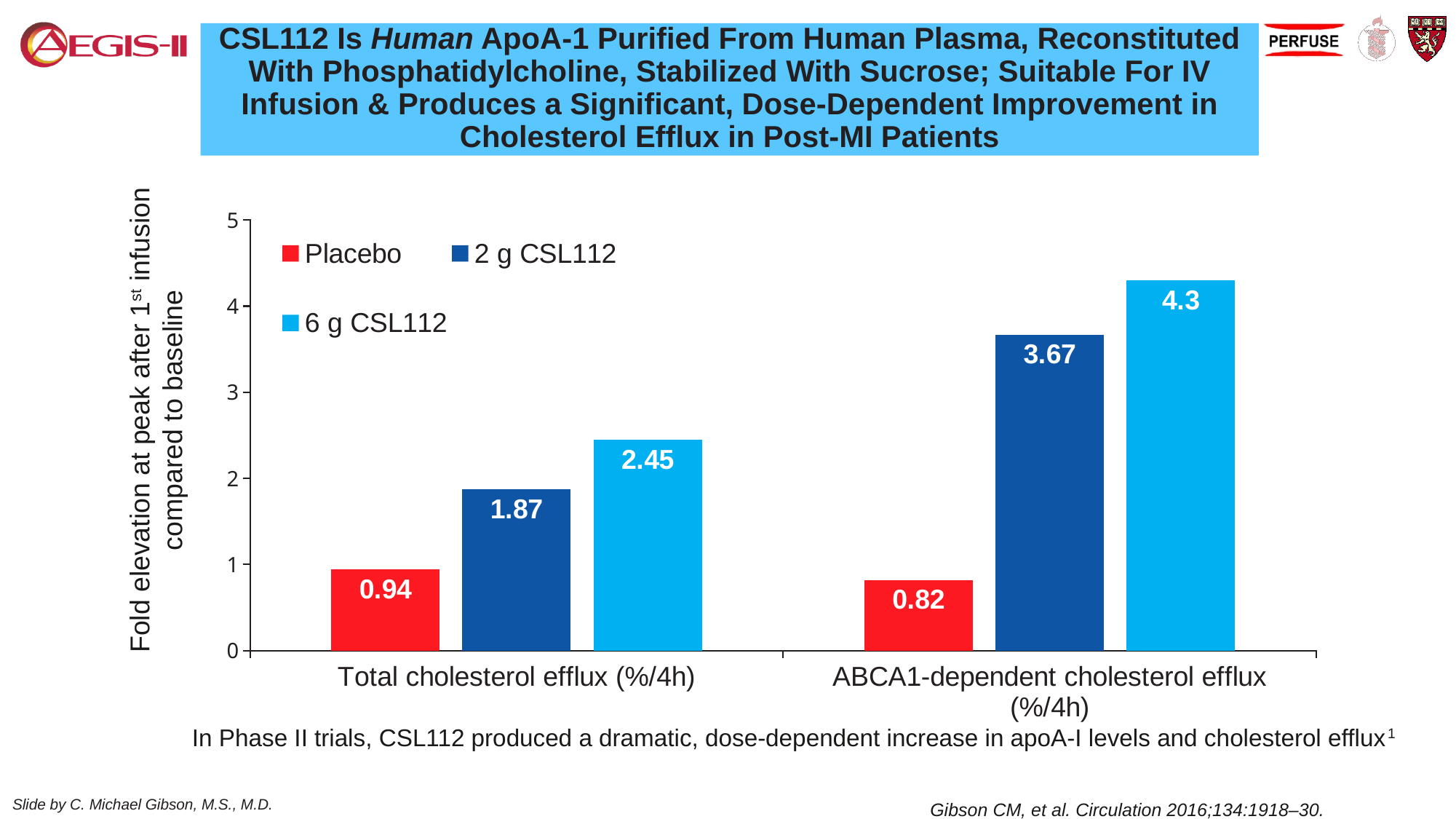
What is the value for 6 g CSL112 in the ABCA1-dependent cholesterol efflux (%/4h) category? 4.3 How many series does the legend list? 3 What is the value for 2 g CSL112 in the Total cholesterol efflux (%/4h) category? 1.87 Which series has the highest value in the ABCA1-dependent cholesterol efflux (%/4h) category? 6 g CSL112 What kind of chart is shown on the slide? Bar chart Is the value for 6 g CSL112 in the Total cholesterol efflux (%/4h) category greater or less than 2? greater How many categories are shown on the x axis? 2 What is the difference between the 6 g CSL112 and Placebo values in the ABCA1-dependent cholesterol efflux (%/4h) category? 3.48 What is the value for Placebo in the Total cholesterol efflux (%/4h) category? 0.94 Which series has the lowest value in the Total cholesterol efflux (%/4h) category? Placebo Which is larger: the 2 g CSL112 value for Total cholesterol efflux or the 2 g CSL112 value for ABCA1-dependent cholesterol efflux? ABCA1-dependent cholesterol efflux What is the difference between the 2 g CSL112 and Placebo values in the Total cholesterol efflux (%/4h) category? 0.93